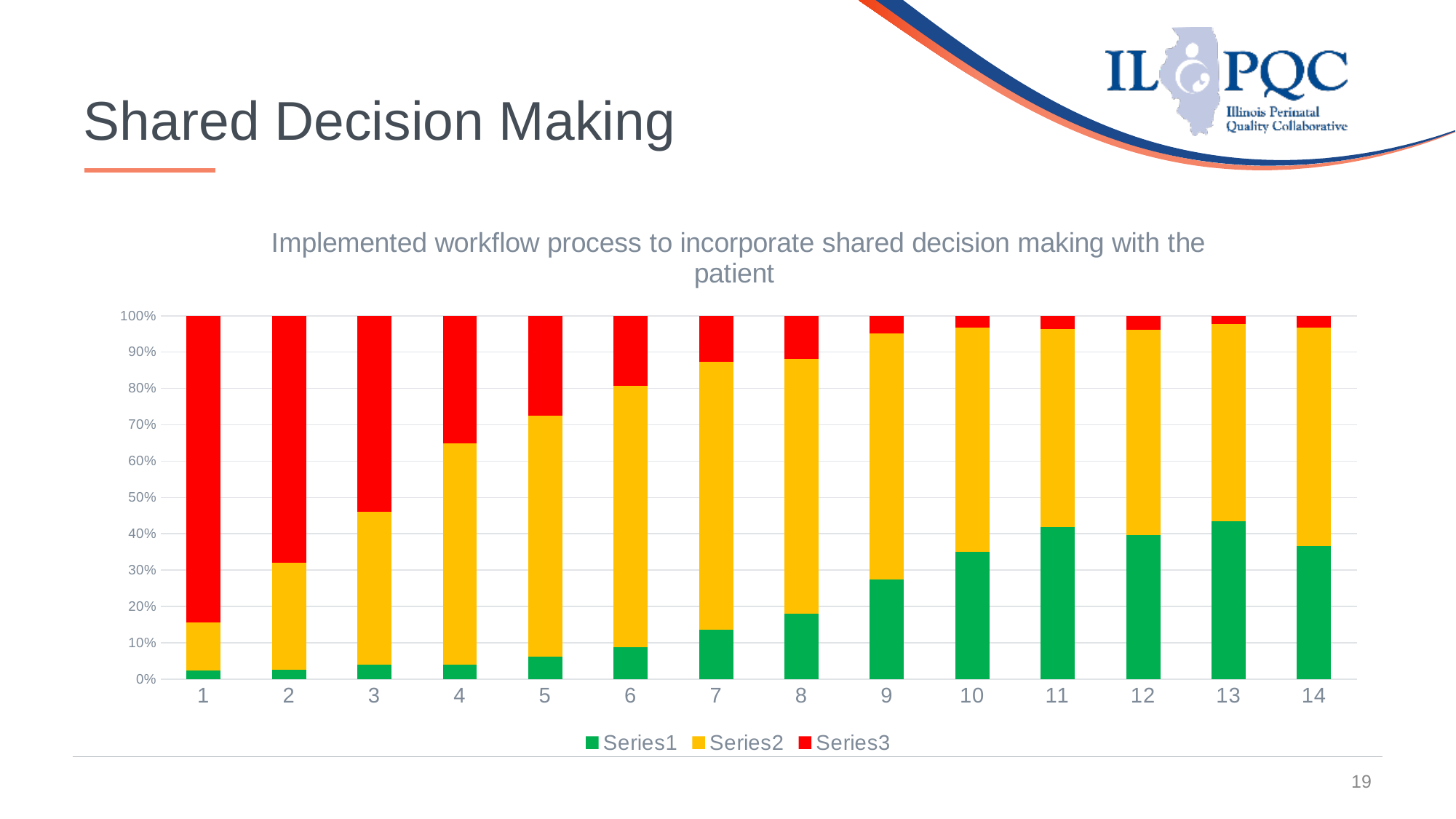
Which is larger, the Series1 value at category 10 or at category 5? Category 10 Which category has the highest value for Series3? 1 Is the value for Series3 at category 1 greater or less than 80%? greater What kind of chart is shown on the slide? Stacked bar chart Which series is shown in red? Series3 What is the total of the stacked bar for category 1? 100% Does the Series1 share generally rise or fall from category 1 to category 14? Rise How many series does the legend list? 3 What is the title of the chart? Implemented workflow process to incorporate shared decision making with the patient How many categories are shown along the x axis? 14 Is the value for Series1 at category 10 greater or less than 30%? greater Is the value for Series1 at category 7 greater or less than 20%? less